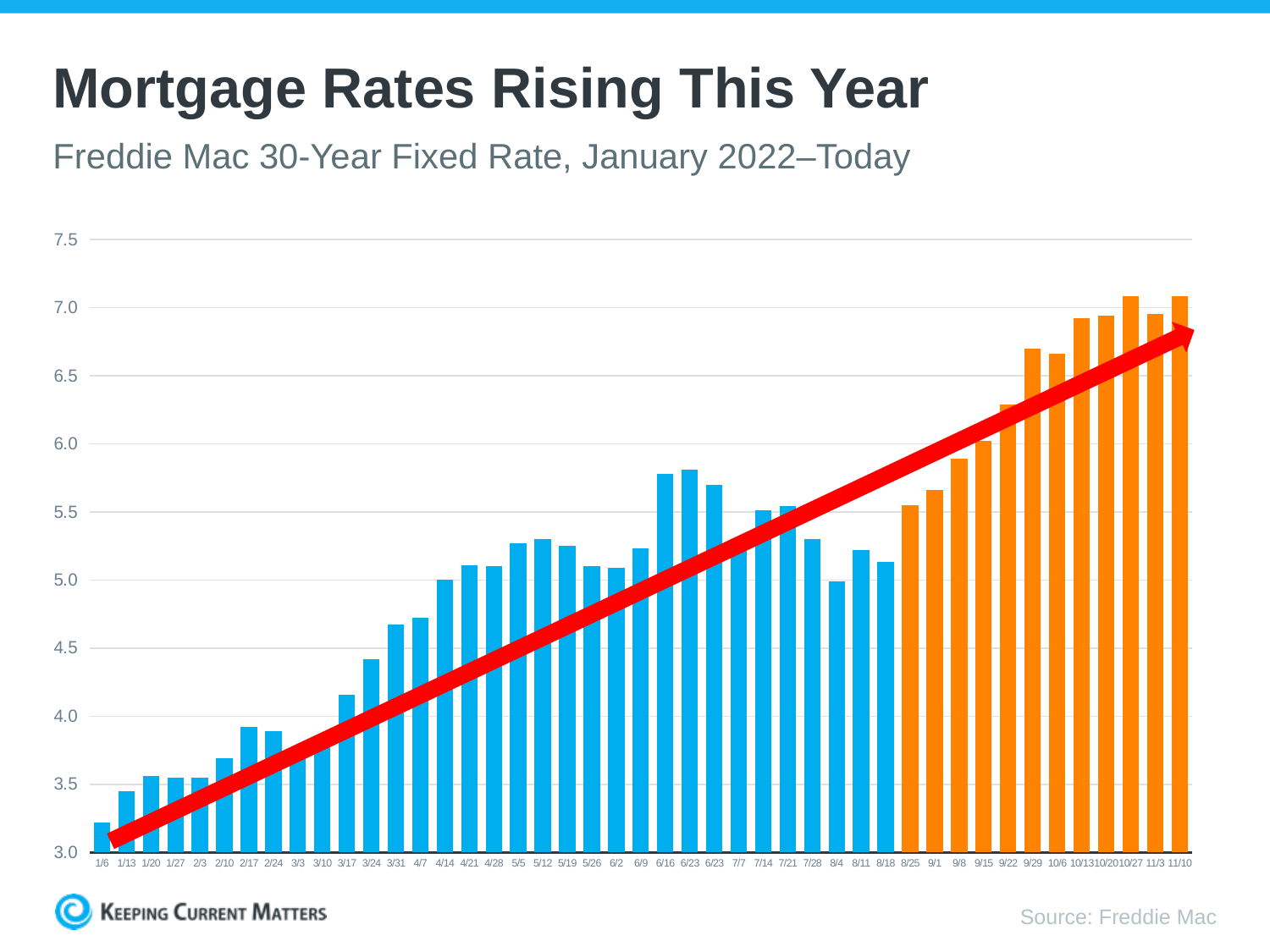
Which date has the lowest 30-year fixed rate on the chart? 1/6 Is the value for 11/10 greater or less than 7.0? greater What source is cited for the chart data? Freddie Mac Do the mortgage rates generally rise or fall from January 2022 to November 2022 along the x axis? rise Which is larger, the value for 6/16 or the value for 8/4? 6/16 Is the value for 4/7 greater or less than 5.0? less Is the value for 6/16 greater or less than 5.5? greater What kind of chart is shown on the slide? bar chart What is the title of the slide? Mortgage Rates Rising This Year